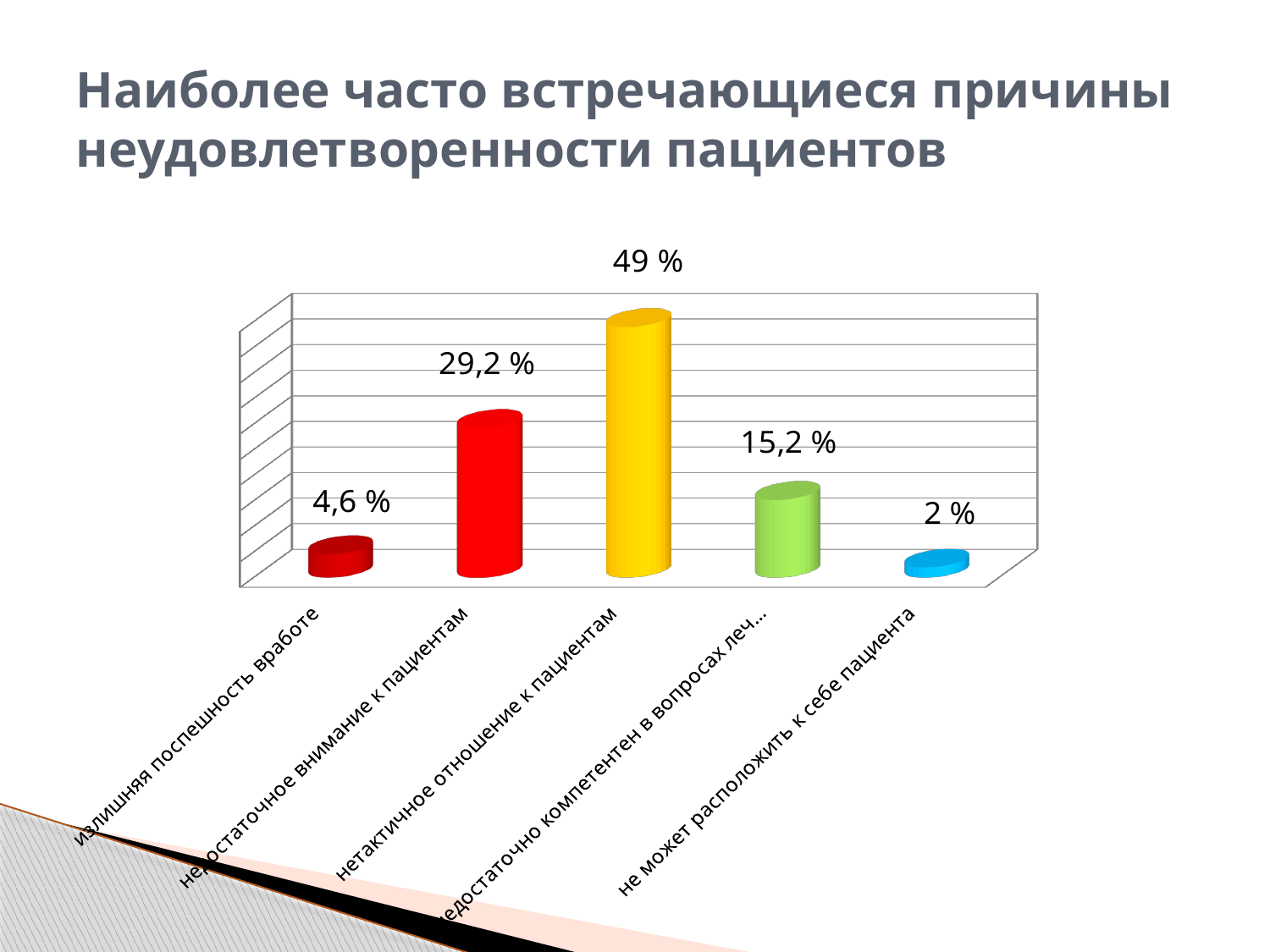
What is the difference between the values for "нетактичное отношение к пациентам" and "недостаточное внимание к пациентам"? 19,8 % Which category has the highest value? нетактичное отношение к пациентам What kind of chart is shown on the slide? bar chart What is the title of the slide? Наиболее часто встречающиеся причины неудовлетворенности пациентов What is the difference between the values for "недостаточное внимание к пациентам" and "излишняя поспешность в работе"? 24,6 % Which is larger: the value for "излишняя поспешность в работе" or the value for "не может расположить к себе пациента"? излишняя поспешность в работе What value is shown for "не может расположить к себе пациента"? 2 % Which category has the lowest value? не может расположить к себе пациента How many categories are shown in the chart? 5 What value is shown for "излишняя поспешность в работе"? 4,6 % What value is shown for "недостаточное внимание к пациентам"? 29,2 % What value is shown for "нетактичное отношение к пациентам"? 49 %